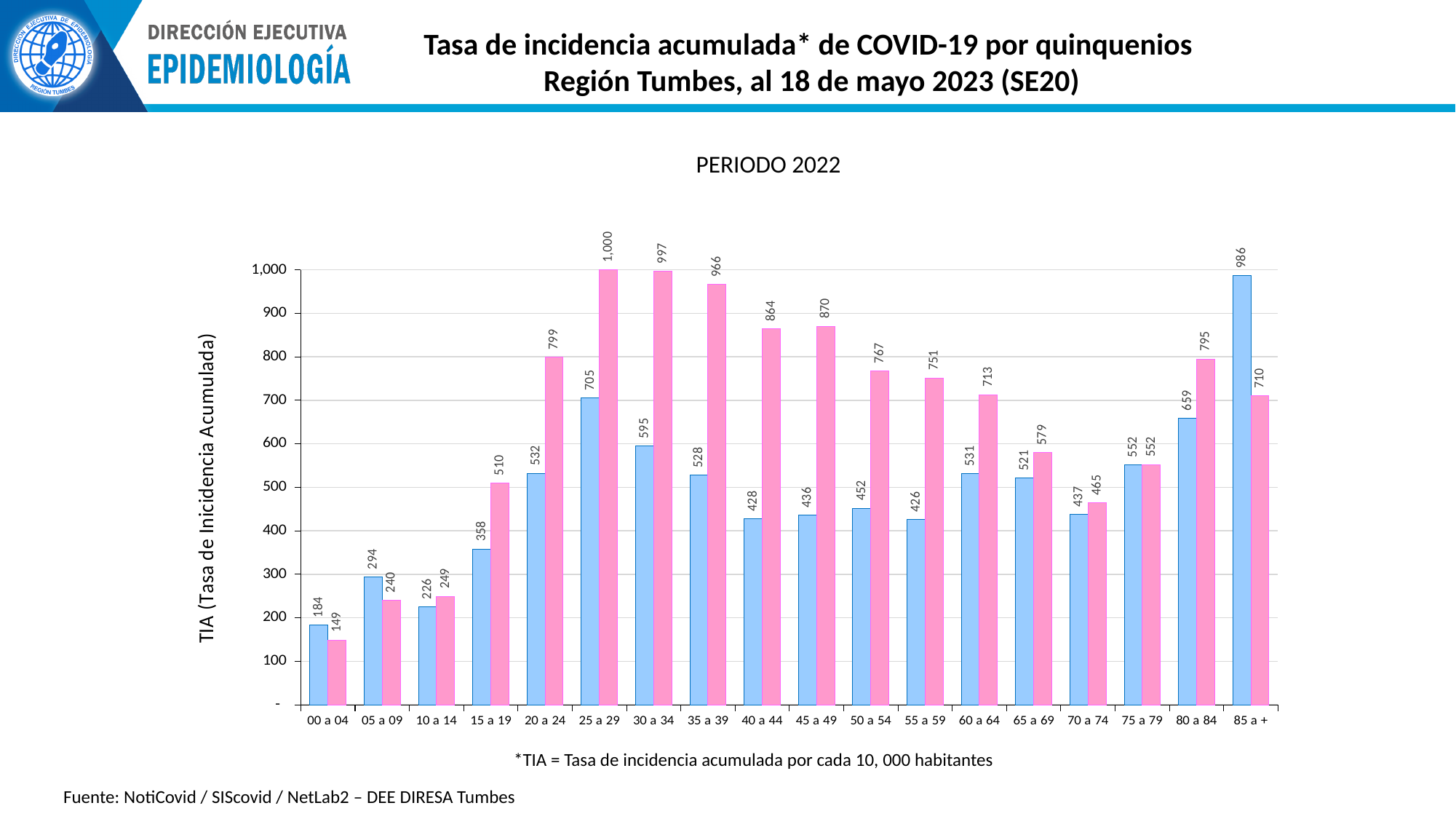
What is the title shown above the chart? PERIODO 2022 How many age-group categories are shown on the x axis? 18 What is the difference between the blue bars for 85 a + and 80 a 84? 327 What is the difference between the pink bar and the blue bar for the 20 a 24 age group? 267 What is the value of the pink bar for the 40 a 44 age group? 864 Which age group has the highest pink bar? 25 a 29 What type of chart is shown on the slide? bar chart For the 85 a + age group, which is larger, the blue bar or the pink bar? the blue bar What is the value of the pink bar for the 75 a 79 age group? 552 Which age group has the highest blue bar? 85 a + What is the value of the blue bar for the 25 a 29 age group? 705 Which age group has the lowest blue bar? 00 a 04